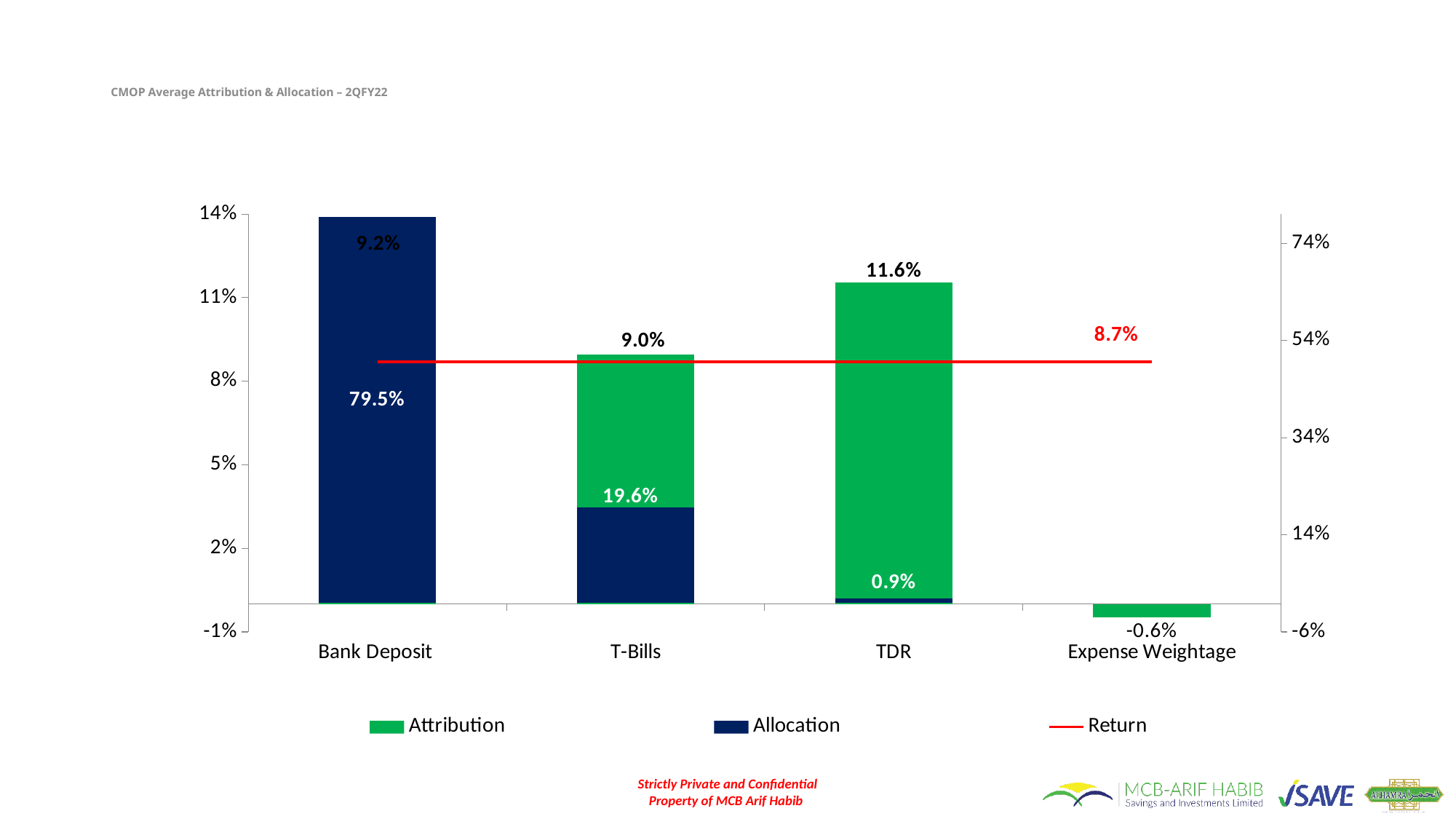
What is the difference between the Attribution values for TDR and T-Bills? 2.6% What is the Attribution value for TDR? 11.6% Which category has the highest Attribution value? TDR Which is larger, the Allocation for Bank Deposit or the Allocation for T-Bills? Bank Deposit What value is shown for the Return line? 8.7% What is the Allocation value for Bank Deposit? 79.5% What is the Attribution value for Bank Deposit? 9.2% How many categories are shown on the x axis? 4 What is the Attribution value for Expense Weightage? -0.6% How many series does the legend list? 3 What is the Allocation value for T-Bills? 19.6% Which category has the lowest Allocation value among those labelled? TDR